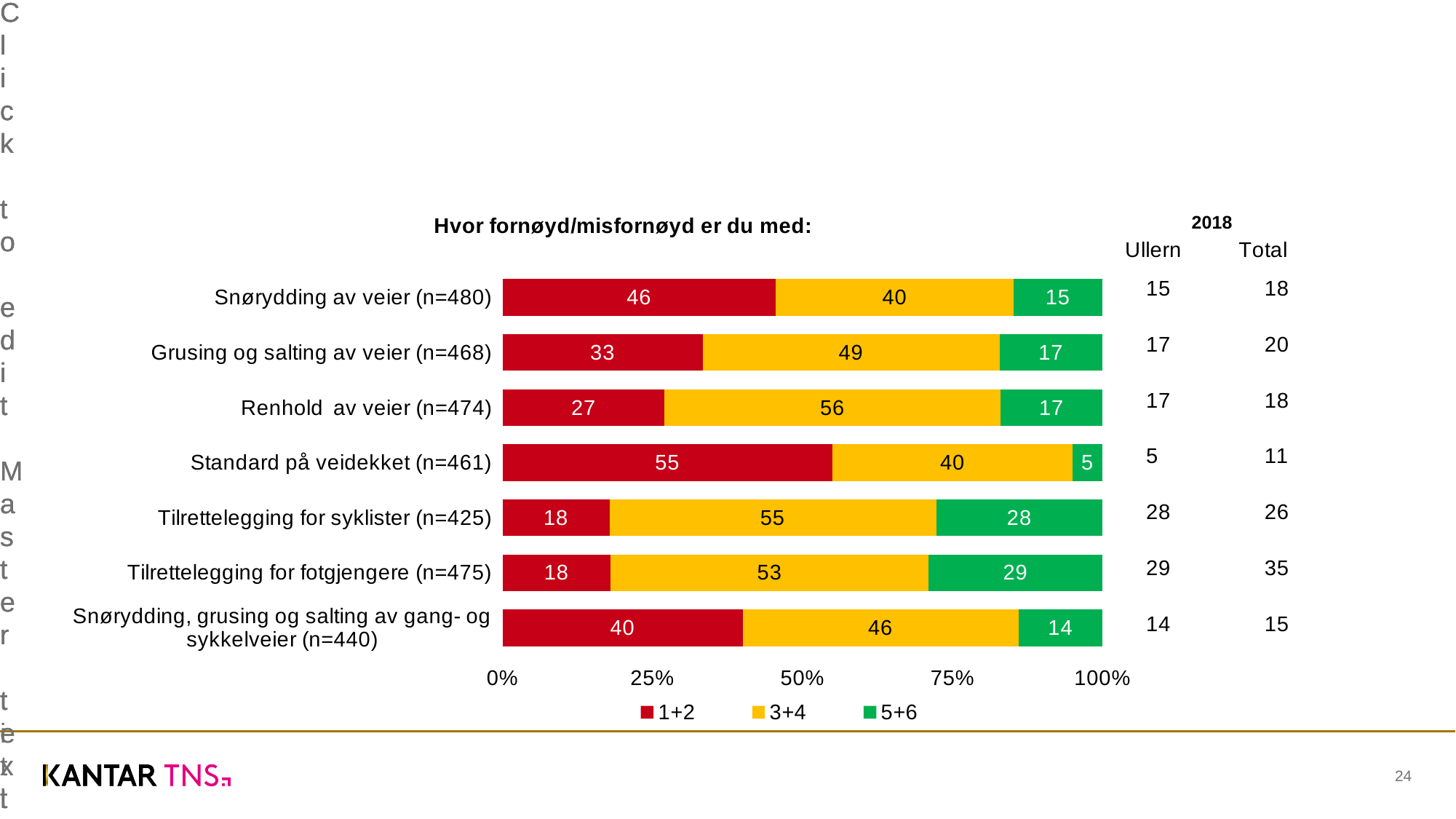
What is the title of the chart? Hvor fornøyd/misfornøyd er du med: Which category has the highest 1+2 value? Standard på veidekket (n=461) What is the value of the 1+2 segment for Standard på veidekket (n=461)? 55 How many series does the legend list? 3 What is the total of the stacked bar for Renhold av veier (n=474)? 100 Which category has the lowest 5+6 value? Standard på veidekket (n=461) Which has the larger 5+6 value: Tilrettelegging for fotgjengere (n=475) or Tilrettelegging for syklister (n=425)? Tilrettelegging for fotgjengere (n=475) How many categories are shown in the chart? 7 What is the value of the 3+4 segment for Renhold av veier (n=474)? 56 What is the difference between the 1+2 values for Snørydding av veier (n=480) and Grusing og salting av veier (n=468)? 13 What kind of chart is shown on the slide? Stacked bar chart What is the value of the 5+6 segment for Tilrettelegging for fotgjengere (n=475)? 29